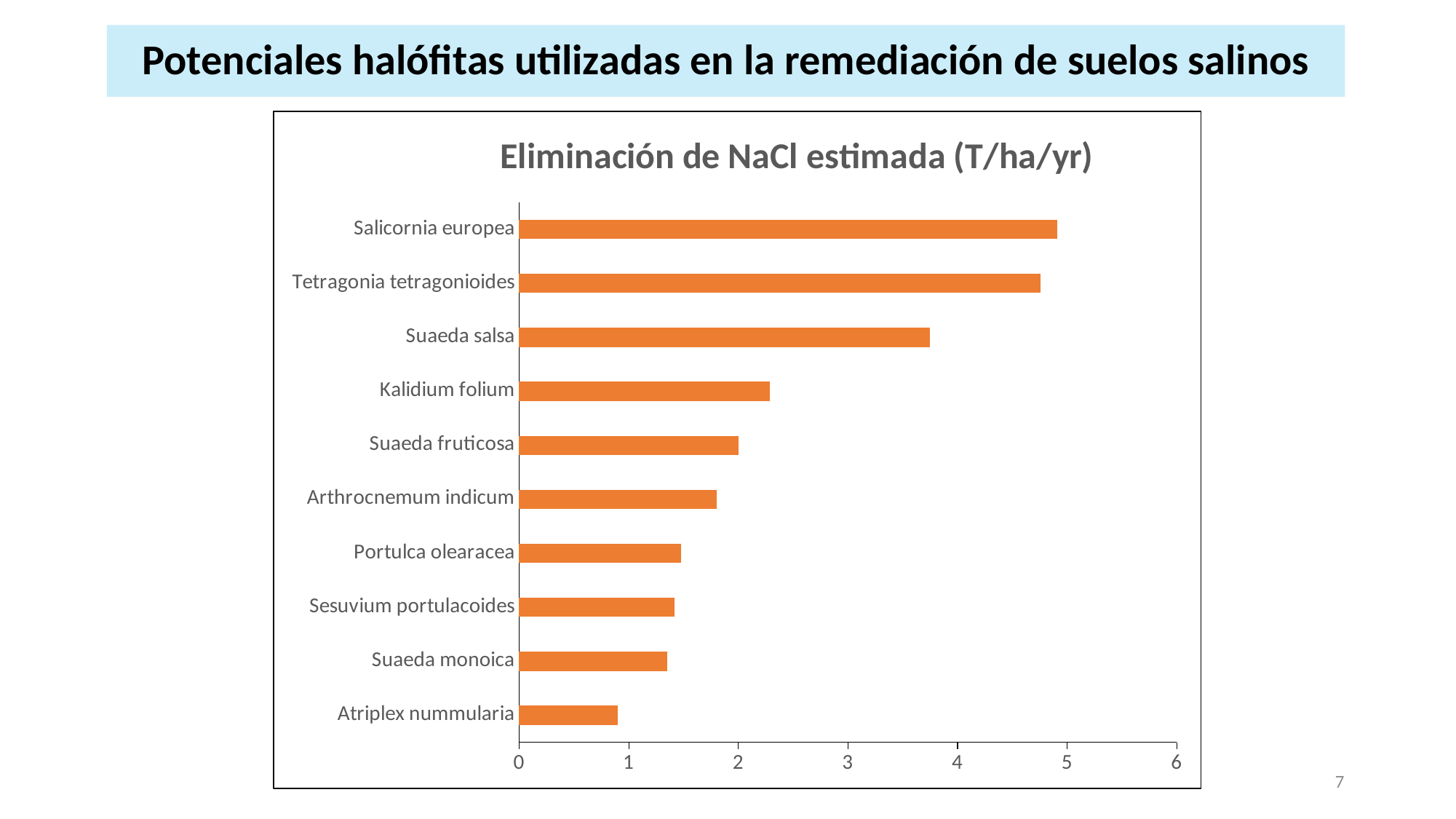
Which has a larger value, Suaeda monoica or Arthrocnemum indicum? Arthrocnemum indicum What kind of chart is shown on the slide? bar chart Is the value for Atriplex nummularia greater or less than 1? less What is the title of the chart? Eliminación de NaCl estimada (T/ha/yr) What colour are the bars in the chart? orange Which species has the highest estimated NaCl removal? Salicornia europea Is the value for Suaeda salsa greater or less than 3? greater Is the value for Kalidium folium greater or less than 2? greater Which has a larger value, Suaeda salsa or Kalidium folium? Suaeda salsa Which species has the lowest estimated NaCl removal? Atriplex nummularia How many plant species are shown in the chart? 10